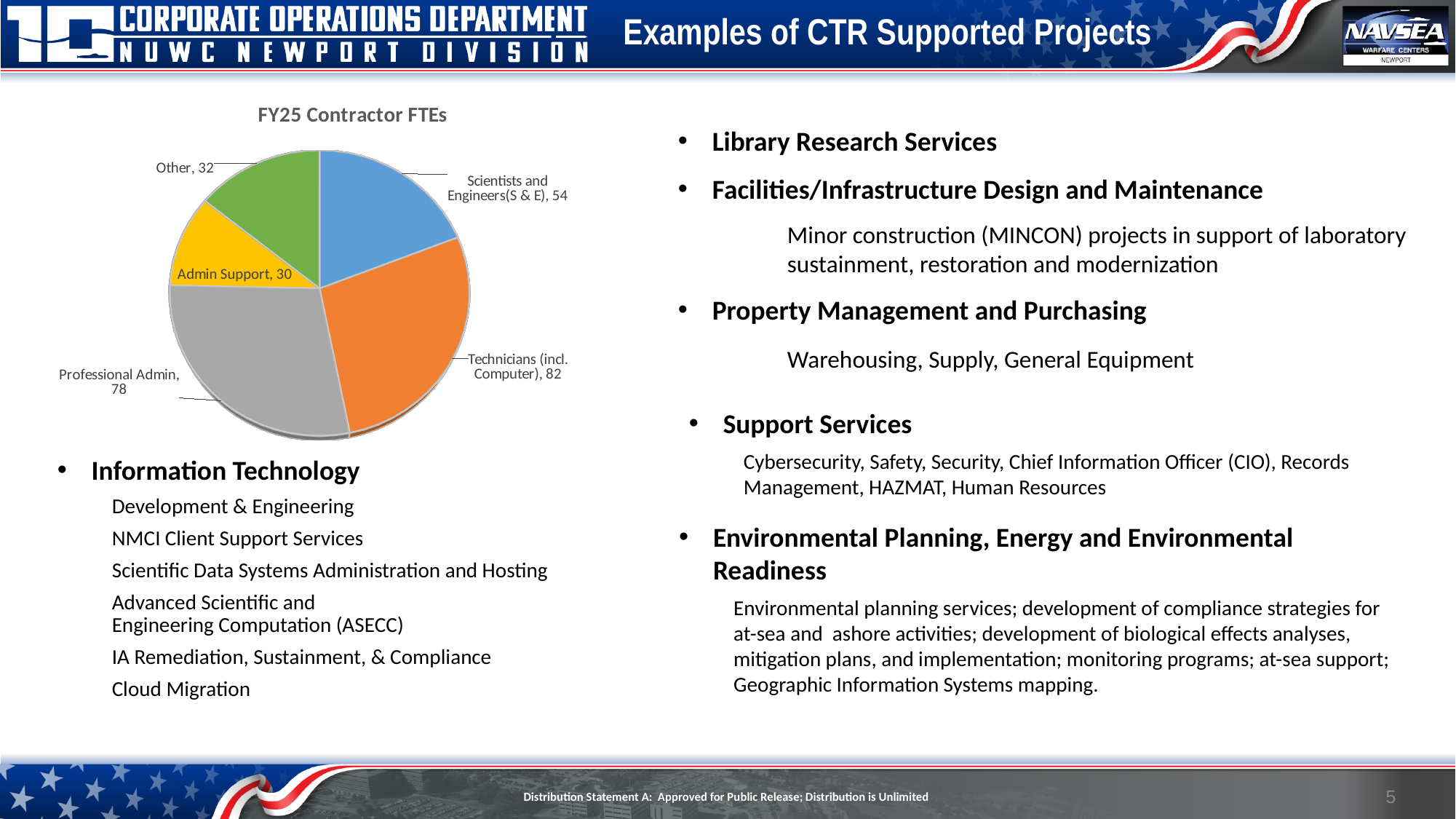
In the FY25 Contractor FTEs pie chart, what is the value for Admin Support? 30 In the FY25 Contractor FTEs pie chart, what is the value for Professional Admin? 78 How many categories are shown in the FY25 Contractor FTEs pie chart? 5 Which category has the smallest slice in the FY25 Contractor FTEs pie chart? Admin Support In the FY25 Contractor FTEs pie chart, what is the difference between Scientists and Engineers (S & E) and Other? 22 In the FY25 Contractor FTEs pie chart, what is the value for Scientists and Engineers (S & E)? 54 In the FY25 Contractor FTEs pie chart, how much larger is the Technicians (incl. Computer) value than the Professional Admin value? 4 What kind of chart is used to show the FY25 Contractor FTEs? Pie chart In the FY25 Contractor FTEs pie chart, what is the value for Technicians (incl. Computer)? 82 In the FY25 Contractor FTEs pie chart, which is larger: Professional Admin or Scientists and Engineers (S & E)? Professional Admin In the FY25 Contractor FTEs pie chart, what is the value for Other? 32